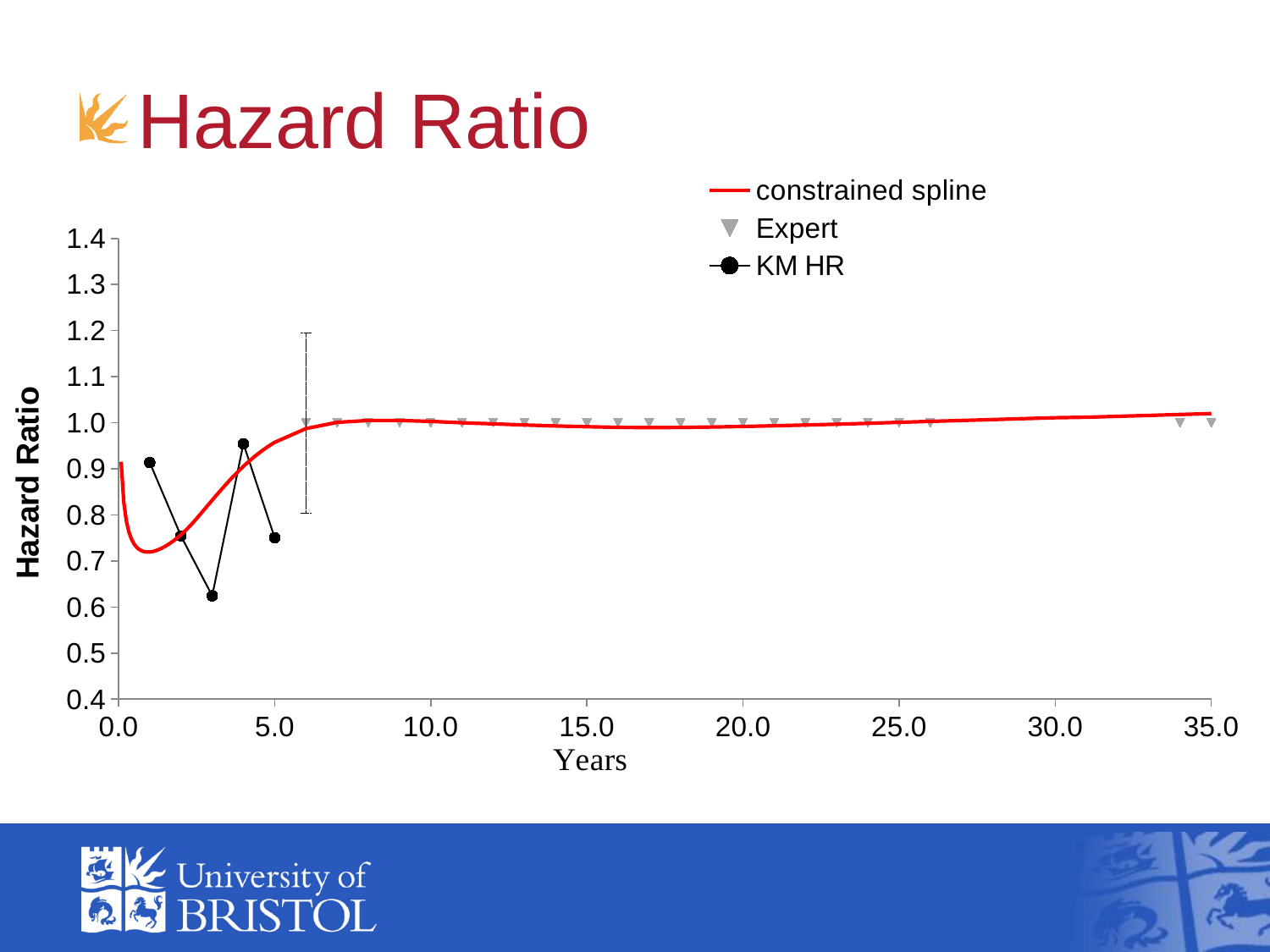
Does the KM HR series rise or fall between year 4 and year 5? fall Is the KM HR value at year 4 greater or less than 0.9? greater What kind of chart is shown on the slide? line chart How many KM HR data points are plotted? 5 At which year is the KM HR value lowest? 3 At which year is the KM HR value highest? 4 Is the KM HR value at year 3 greater or less than 0.7? less Which is larger, the KM HR value at year 1 or at year 2? year 1 What is the label of the x axis? Years What is the title of the chart? Hazard Ratio How many series does the legend list? 3 Is the KM HR value at year 5 greater or less than 0.8? less